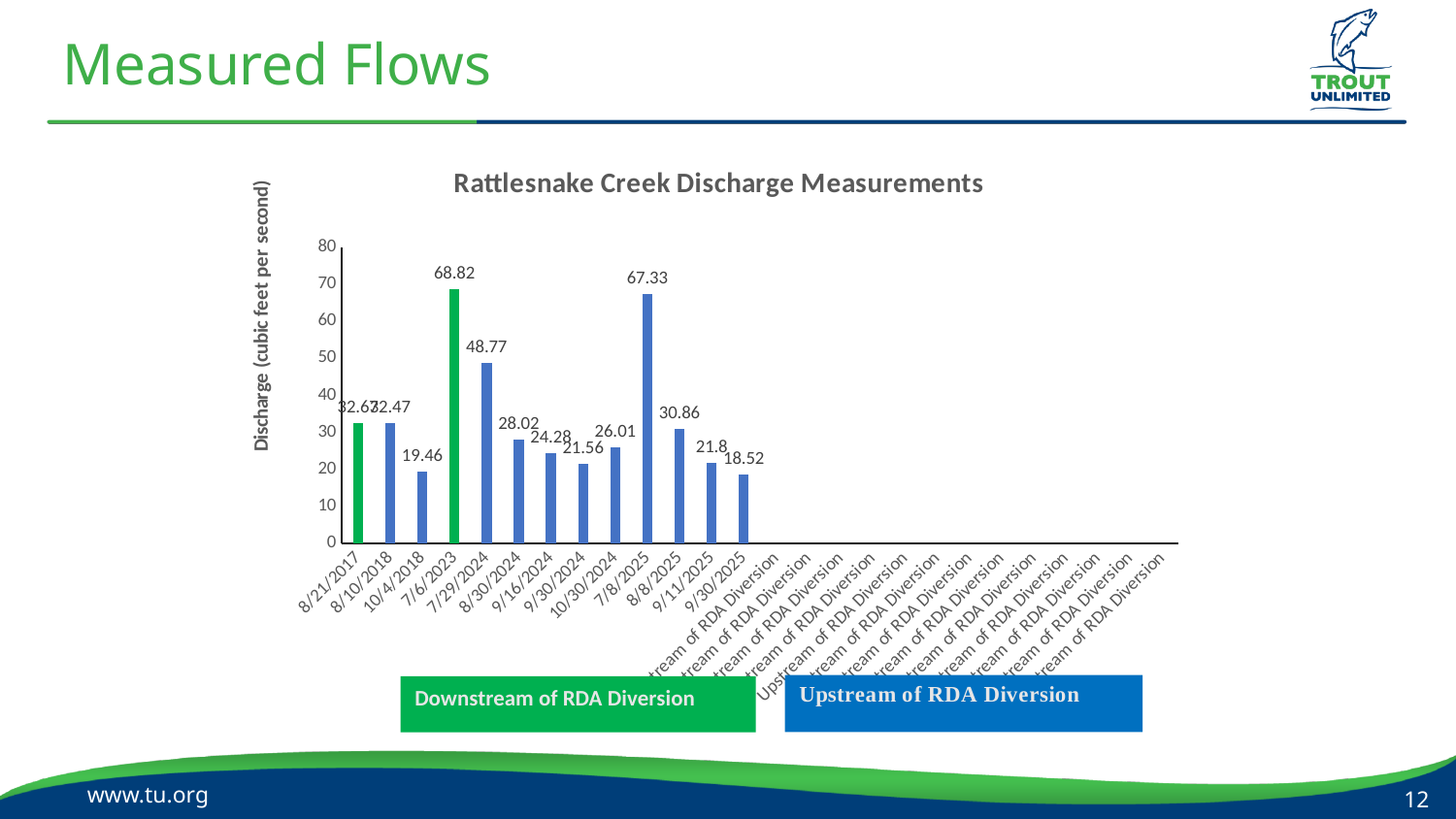
What is the difference between the discharge on 7/6/2023 and on 7/8/2025? 1.49 Which has a larger discharge value, 8/30/2024 or 10/30/2024? 8/30/2024 What is the discharge value for 7/29/2024? 48.77 What is the title of the vertical axis of the chart? Discharge (cubic feet per second) Is the discharge value for 7/29/2024 greater or less than 40? greater How many bars with values are plotted in the chart? 13 What kind of chart is used to show the Rattlesnake Creek Discharge Measurements? bar chart What is the discharge value for 7/8/2025? 67.33 Which date has the highest discharge measurement? 7/6/2023 What is the discharge value for 7/6/2023 in the Rattlesnake Creek Discharge Measurements chart? 68.82 Which date has the lowest discharge measurement among the plotted bars? 9/30/2025 What is the discharge value for 10/4/2018? 19.46